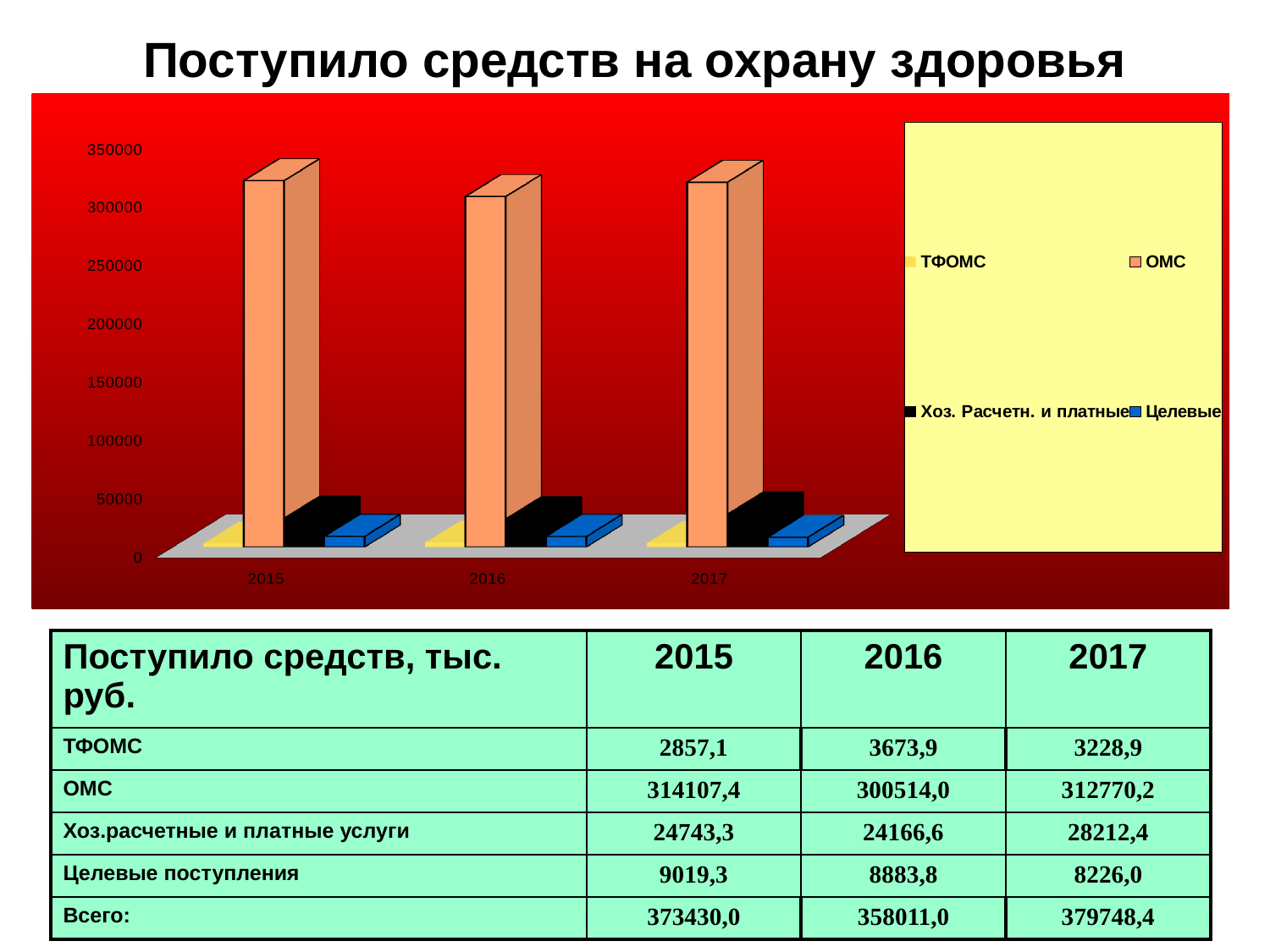
What kind of chart is shown on the slide? bar chart Do the Целевые поступления values rise or fall from 2015 to 2017? fall Which series has the tallest bars in the chart? ОМС Which year had the larger ОМС amount, 2015 or 2016? 2015 According to the table, what was the ОМС amount in 2015? 314107,4 How many series does the chart legend list? 4 Is the ОМС bar for 2016 greater or less than 250000? greater Is the bar for Хоз. Расчетн. и платные in 2017 greater or less than 50000? less According to the table, what was the total (Всего) in 2017? 379748,4 How many years are shown along the x axis of the chart? 3 By how much did ТФОМС receipts in 2016 exceed those in 2015, according to the table? 816,8 Which year had the lowest total (Всего) in the table? 2016